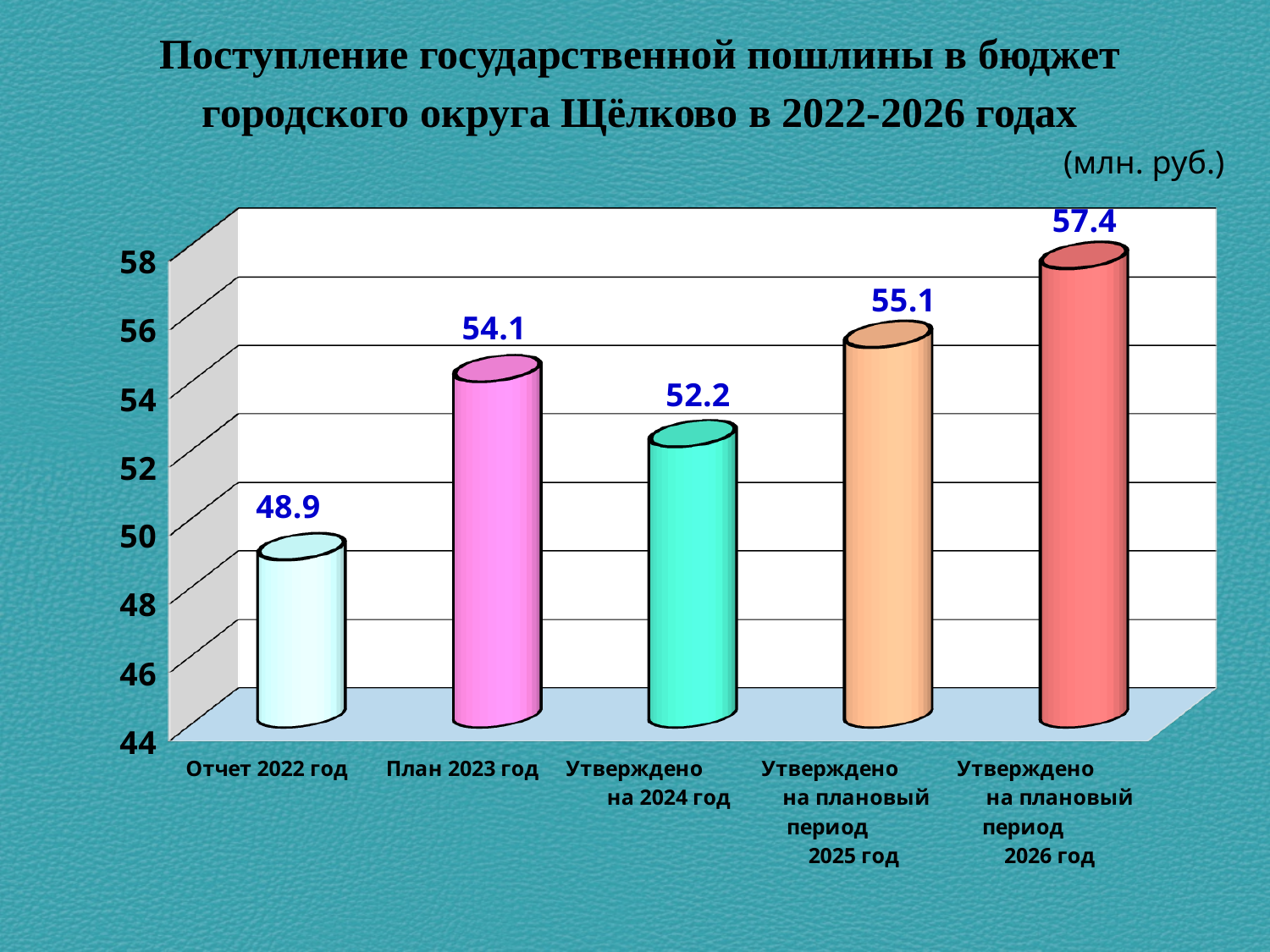
Which is larger: the value for План 2023 год or the value for Утверждено на 2024 год? План 2023 год Which category has the lowest value? Отчет 2022 год What is the value for Утверждено на 2024 год? 52.2 What is the value for Отчет 2022 год? 48.9 What is the value for План 2023 год? 54.1 What unit is indicated for the values on the chart? млн. руб. What kind of chart is shown on the slide? bar chart What is the value for Утверждено на плановый период 2026 год? 57.4 Which category has the highest value? Утверждено на плановый период 2026 год How many categories are shown on the chart? 5 What is the difference between the values for Утверждено на плановый период 2026 год and Отчет 2022 год? 8.5 Is the value for Утверждено на плановый период 2025 год greater or less than 54? greater